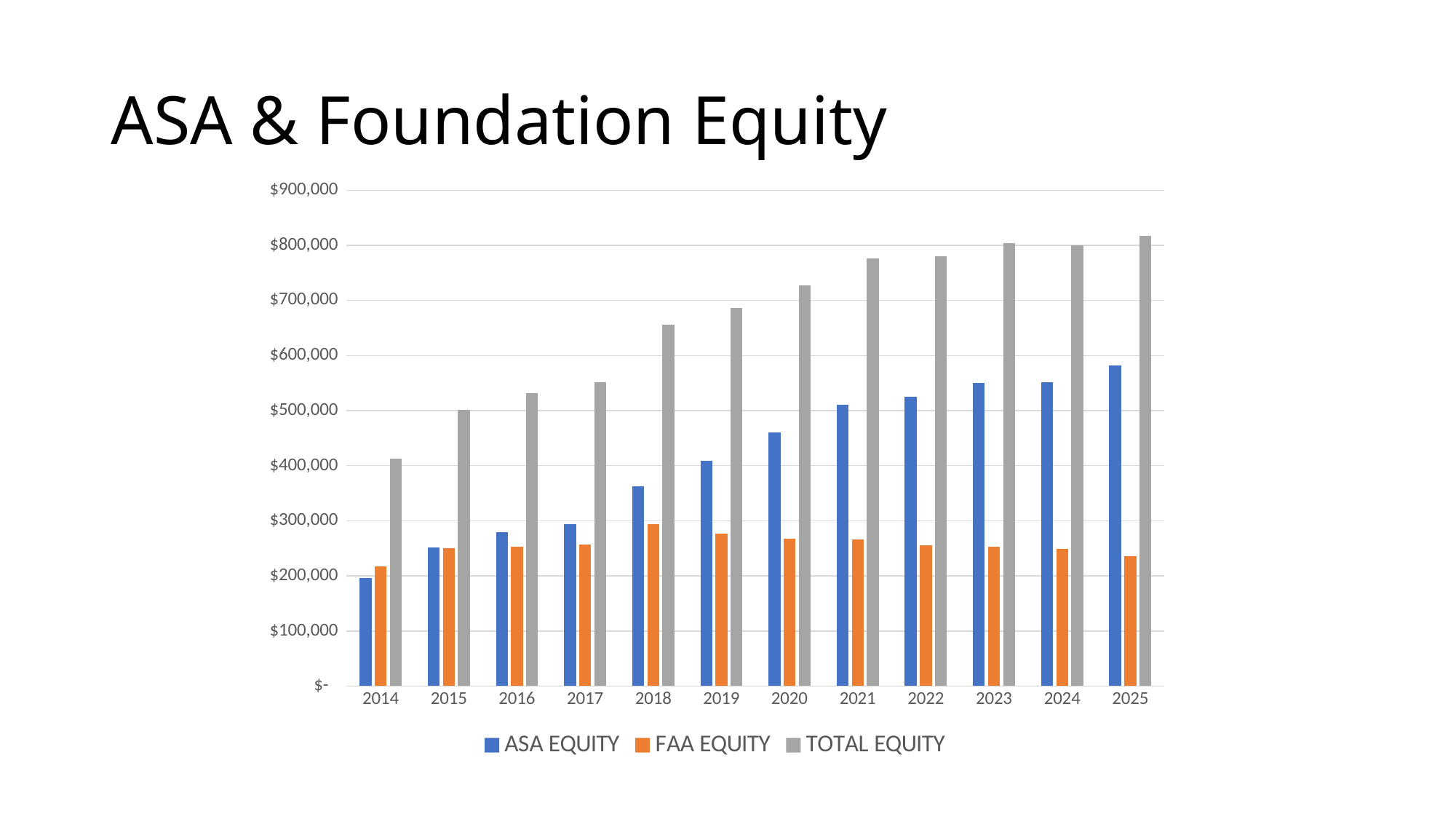
In which year is ASA EQUITY highest? 2025 How many years are shown on the x axis? 12 Is the ASA EQUITY value for 2020 greater or less than $500,000? less How many series does the legend list? 3 What colour represents TOTAL EQUITY in the legend? grey What kind of chart is shown on the slide? bar chart Is the TOTAL EQUITY value for 2025 greater or less than $800,000? greater In 2014, which is larger: ASA EQUITY or FAA EQUITY? FAA EQUITY In which year is TOTAL EQUITY highest? 2025 In which year is ASA EQUITY lowest? 2014 In which year is FAA EQUITY highest? 2018 Does TOTAL EQUITY generally rise or fall from 2014 to 2025? rise